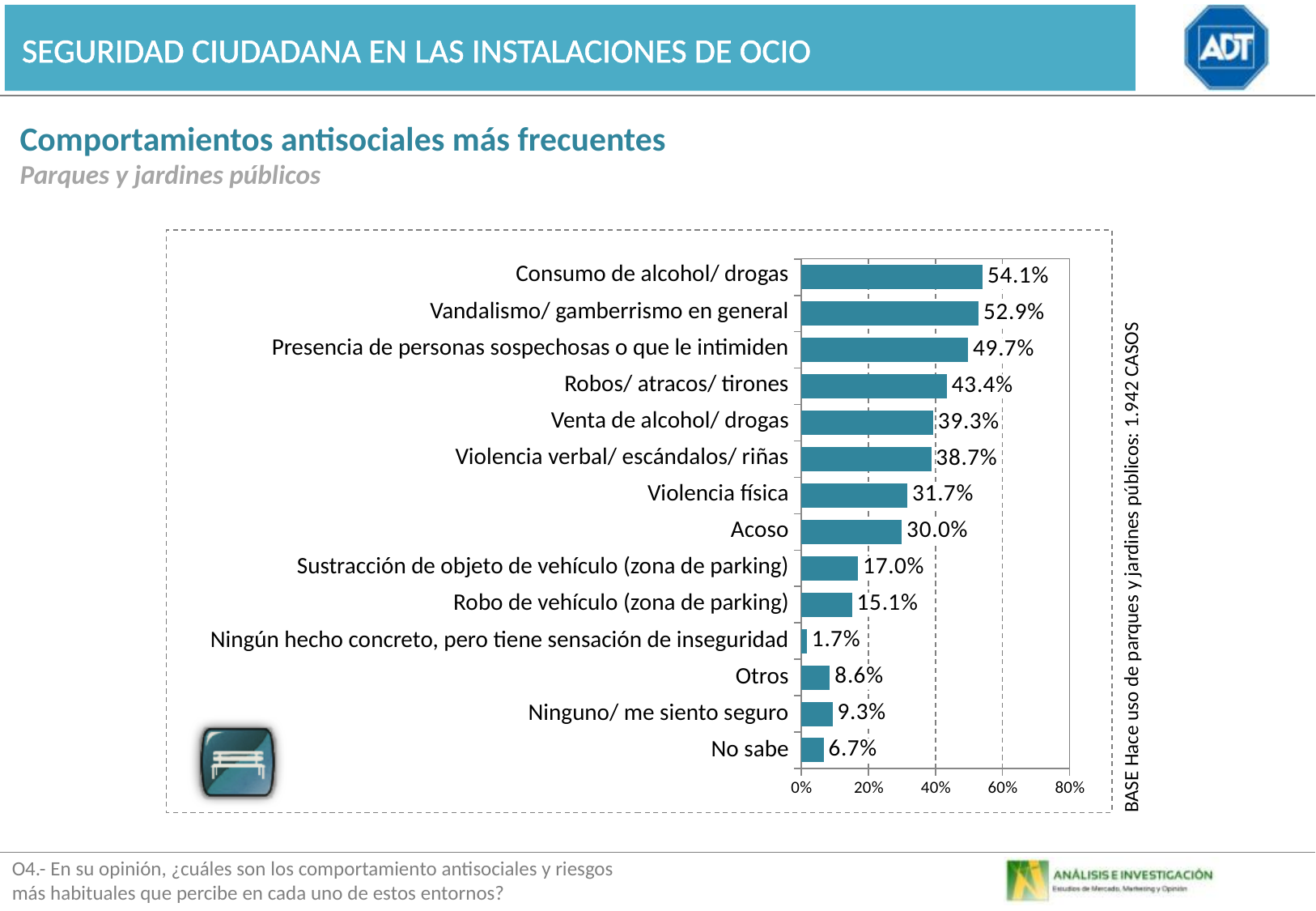
How many categories are shown in the chart? 14 What is the value for Acoso? 30.0% What is the subtitle shown under the chart title 'Comportamientos antisociales más frecuentes'? Parques y jardines públicos What is the value for Consumo de alcohol/ drogas? 54.1% Which category has the highest value? Consumo de alcohol/ drogas What kind of chart is shown on the slide? Bar chart What is the value for Robo de vehículo (zona de parking)? 15.1% What is the difference between Consumo de alcohol/ drogas and Vandalismo/ gamberrismo en general? 1.2% What is the value for Robos/ atracos/ tirones? 43.4% Is the value for Presencia de personas sospechosas o que le intimiden greater or less than 40%? greater Which is larger, Violencia física or Acoso? Violencia física Which category has the lowest value? Ningún hecho concreto, pero tiene sensación de inseguridad